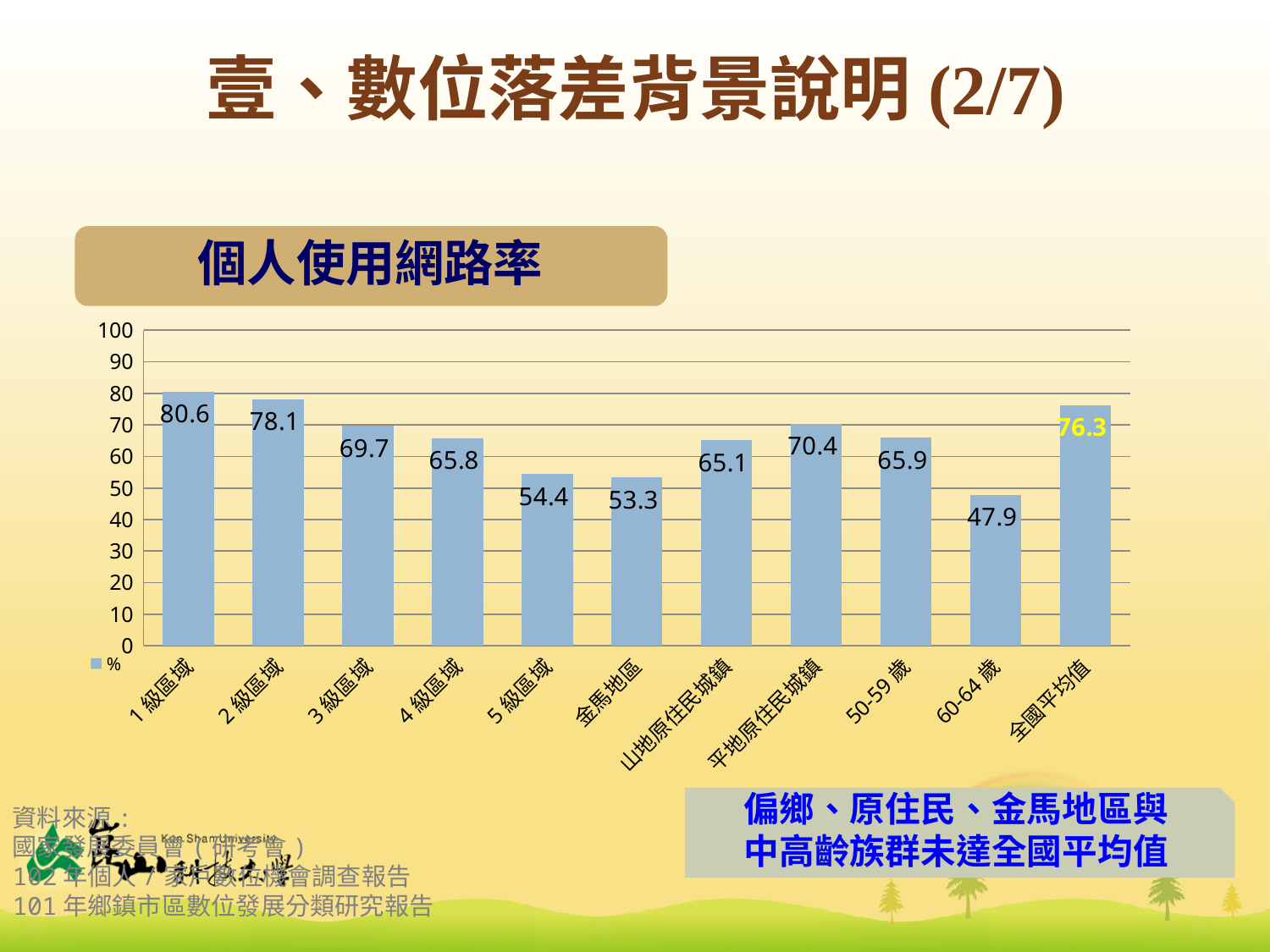
What is the value for 全國平均值? 76.3 What is the value for 金馬地區? 53.3 Is the value for 5級區域 greater or less than 60? less What is the difference between the values for 1級區域 and 全國平均值? 4.3 What is the value for 60-64歲? 47.9 What is the value for 1級區域 in the 個人使用網路率 chart? 80.6 Which category has the lowest value? 60-64歲 What kind of chart is shown on the slide? bar chart How many categories are shown on the x axis? 11 Which category has the highest value? 1級區域 Which is larger, the value for 平地原住民城鎮 or 山地原住民城鎮? 平地原住民城鎮 What is the title shown above the chart? 個人使用網路率